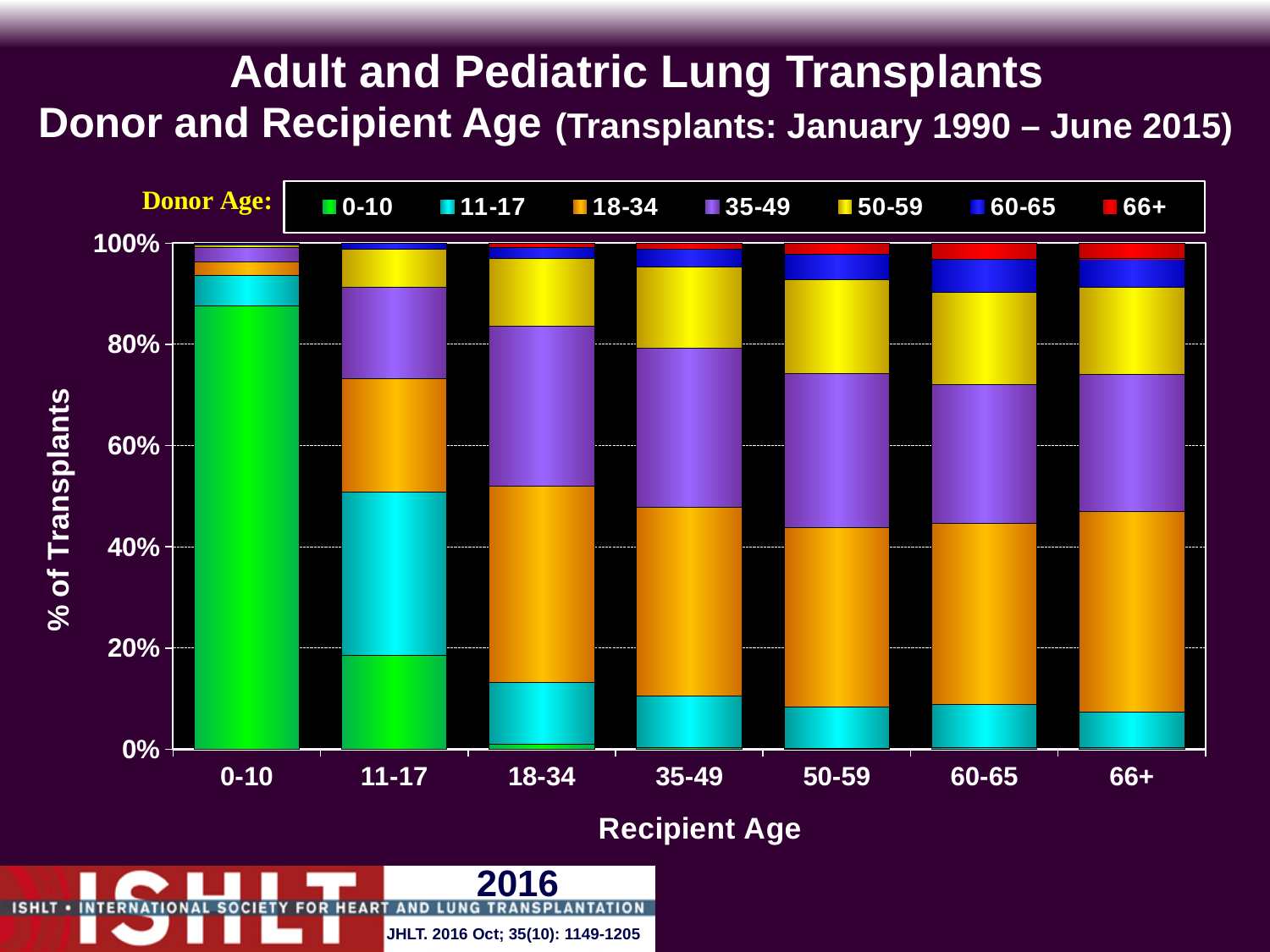
Does the share of transplants from 0-10 year old donors rise or fall as recipient age increases along the x axis? Fall Which recipient age group has the largest share of transplants from 0-10 year old donors? 0-10 What kind of chart is shown on the slide? Stacked bar chart Which recipient age group has a larger share of 11-17 donors: 11-17 or 18-34? 11-17 What does the legend represent, according to the label next to it? Donor Age How many recipient age categories are shown on the x axis? 7 Is the share of 0-10 donors for the 0-10 recipient age group greater or less than 80%? greater Is the share of 35-49 donors for the 18-34 recipient age group greater or less than 20%? greater How many donor age groups does the legend list? 7 What is the label of the x axis? Recipient Age Is the share of 11-17 donors for the 11-17 recipient age group greater or less than 20%? greater